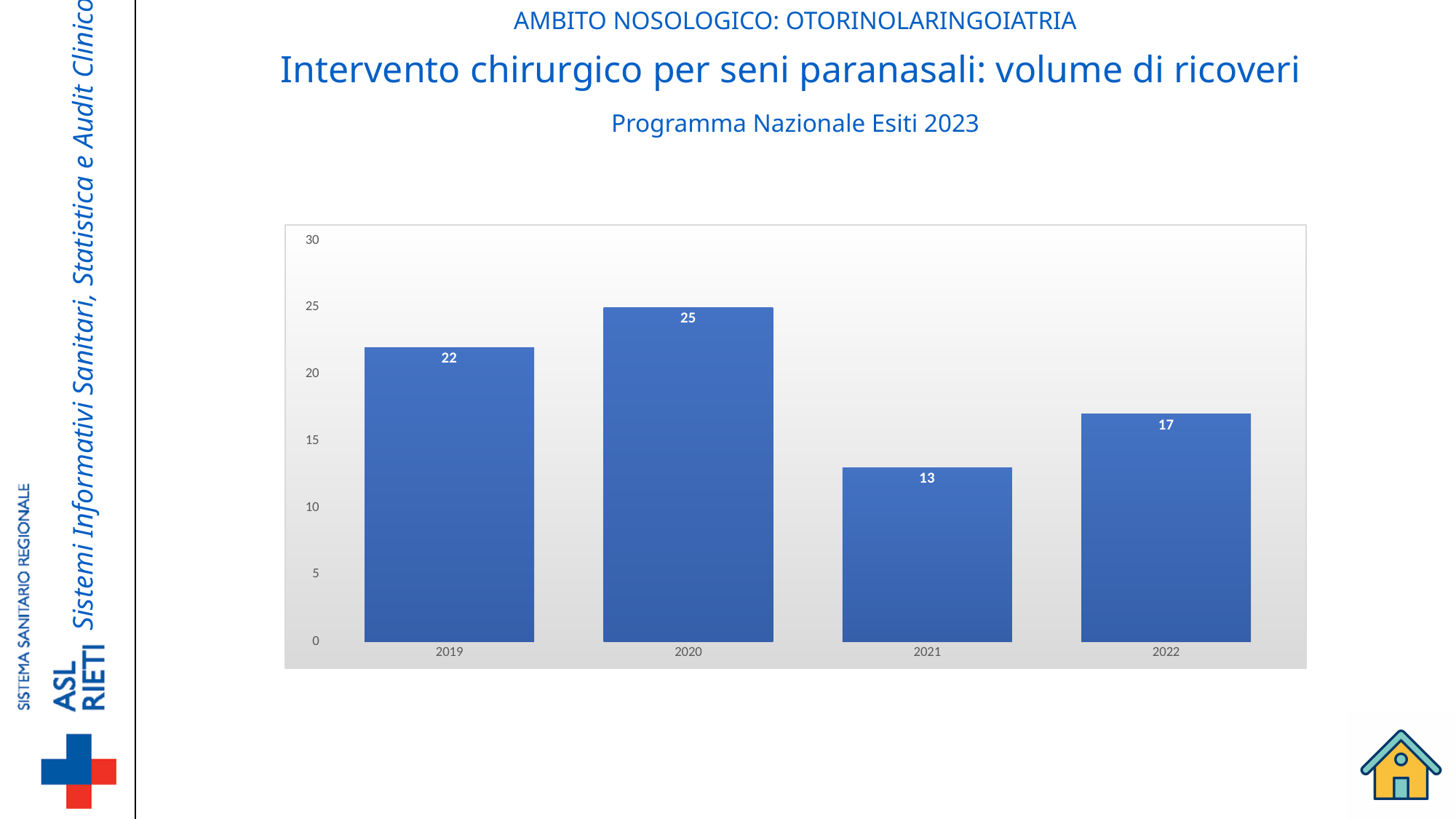
What is the value for 2021? 13 Which year has the highest value? 2020 What kind of chart is shown on the slide? bar chart Which is larger, the value for 2019 or the value for 2022? 2019 How many years are shown on the x axis? 4 What is the value for 2019? 22 What is the difference between the values for 2020 and 2021? 12 What is the value for 2020? 25 Which year has the lowest value? 2021 Does the value rise or fall from 2020 to 2021? fall Is the value for 2022 greater or less than 15? greater What is the value for 2022? 17